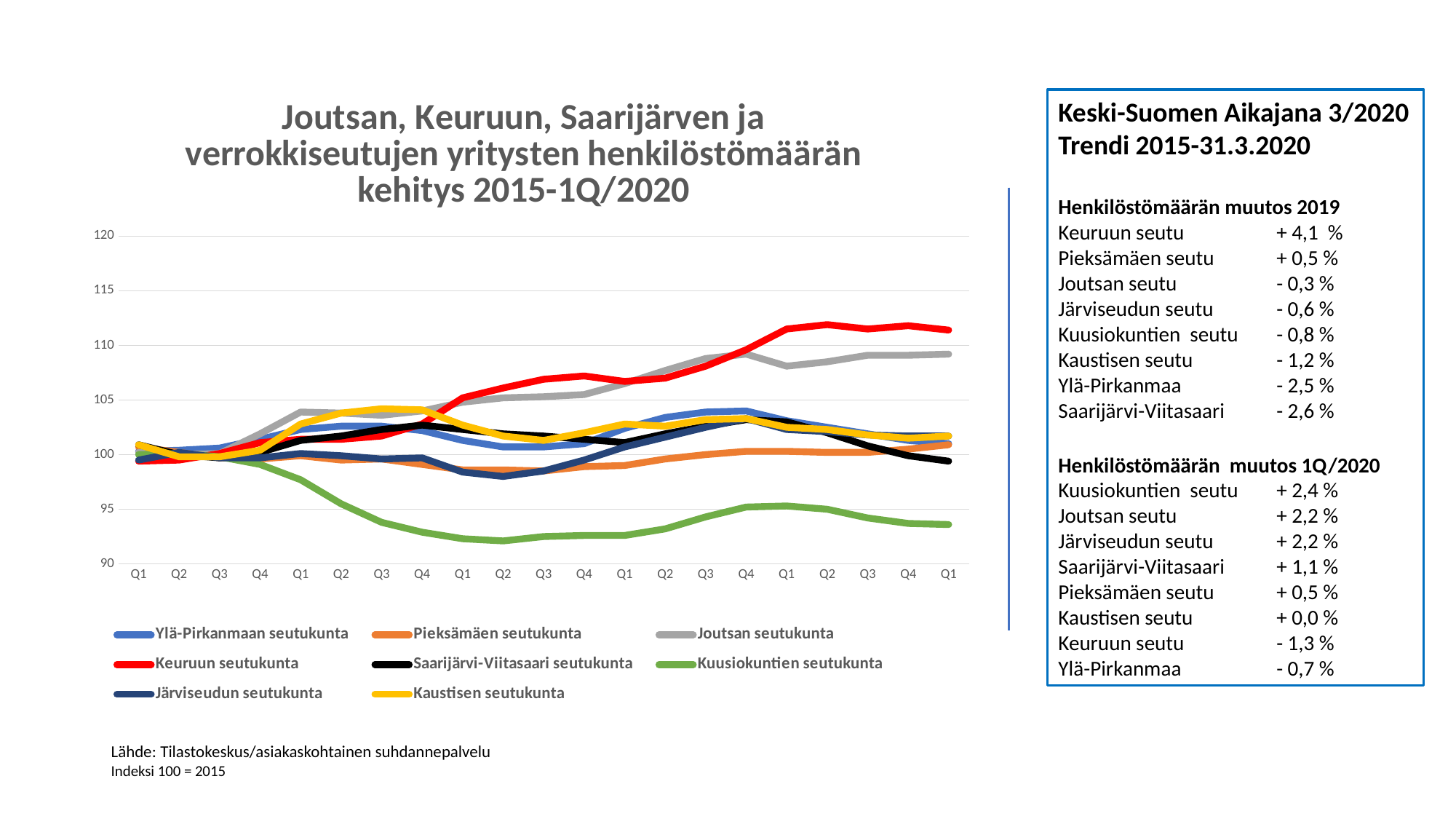
Is the value for Joutsan seutukunta at the last point on the chart greater or less than 105? greater What kind of chart is shown on the slide? line chart At the last point on the chart, which is higher: Keuruun seutukunta or Joutsan seutukunta? Keuruun seutukunta Is the value for Keuruun seutukunta at the last point on the chart greater or less than 110? greater Which series has the highest value at the last point (Q1 2020) on the chart? Keuruun seutukunta Does the Keuruun seutukunta line overall rise or fall from the first point to the last point on the chart? rise How many series does the chart legend list? 8 Does the Kuusiokuntien seutukunta line overall rise or fall from the first point to the last point on the chart? fall What colour is the line for Keuruun seutukunta in the chart? red Which series has the lowest value at the last point (Q1 2020) on the chart? Kuusiokuntien seutukunta How many quarterly points are plotted along the x axis of the chart? 21 Is the value for Kuusiokuntien seutukunta at the last point on the chart greater or less than 95? less